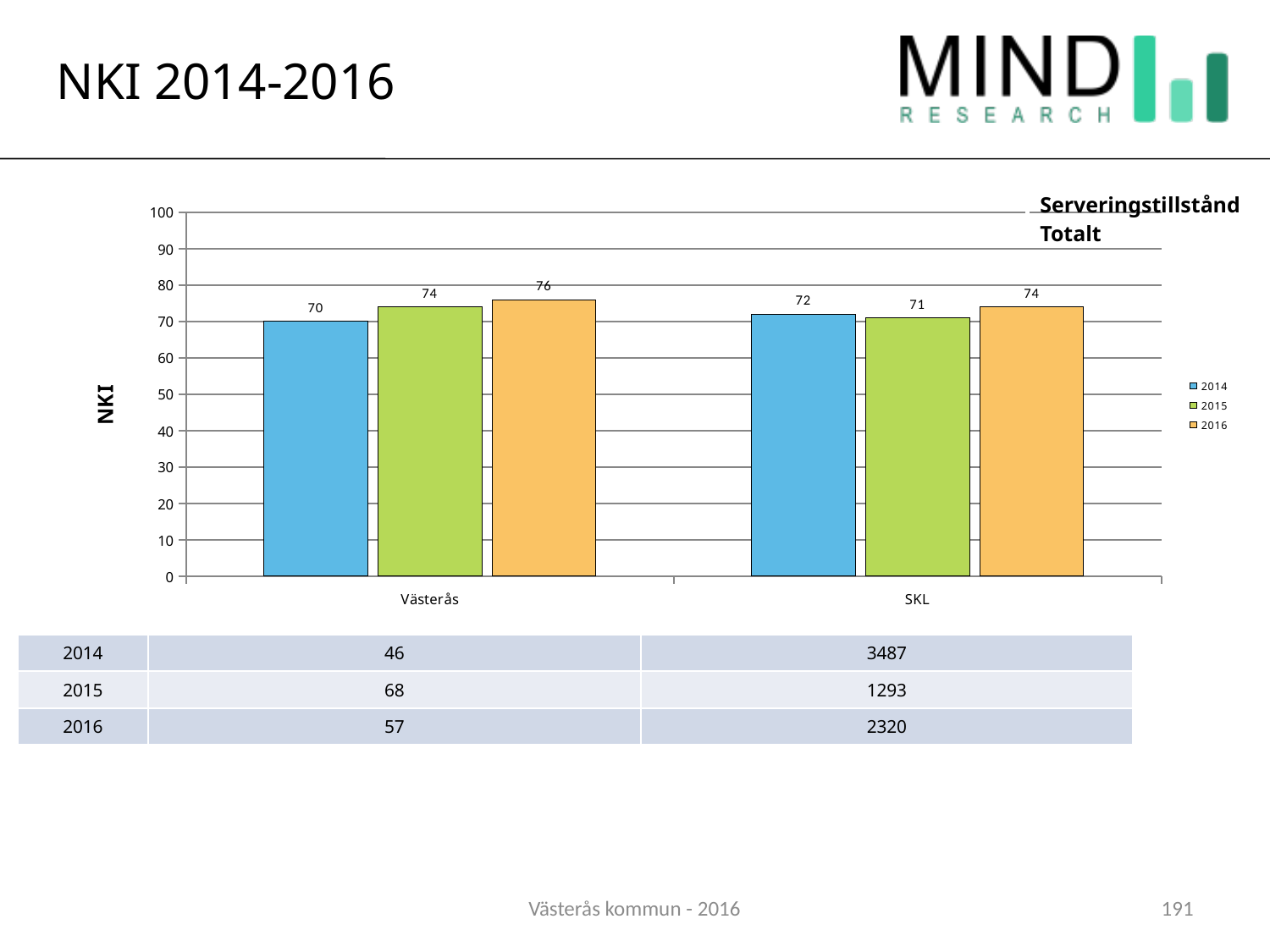
What is the label on the vertical axis of the chart? NKI How many series does the legend list? 3 Which year has the lowest NKI value for SKL? 2015 What is the NKI value for Västerås in 2014? 70 What is the NKI value for SKL in 2016? 74 What kind of chart is shown on the slide? bar chart How many categories are shown on the x axis of the chart? 2 Which year has the highest NKI value for Västerås? 2016 Which is larger, the 2014 NKI value for Västerås or the 2014 NKI value for SKL? SKL What is the difference between the 2016 and 2014 NKI values for Västerås? 6 Is the 2016 NKI value for Västerås greater or less than 80? less What is the NKI value for SKL in 2015? 71